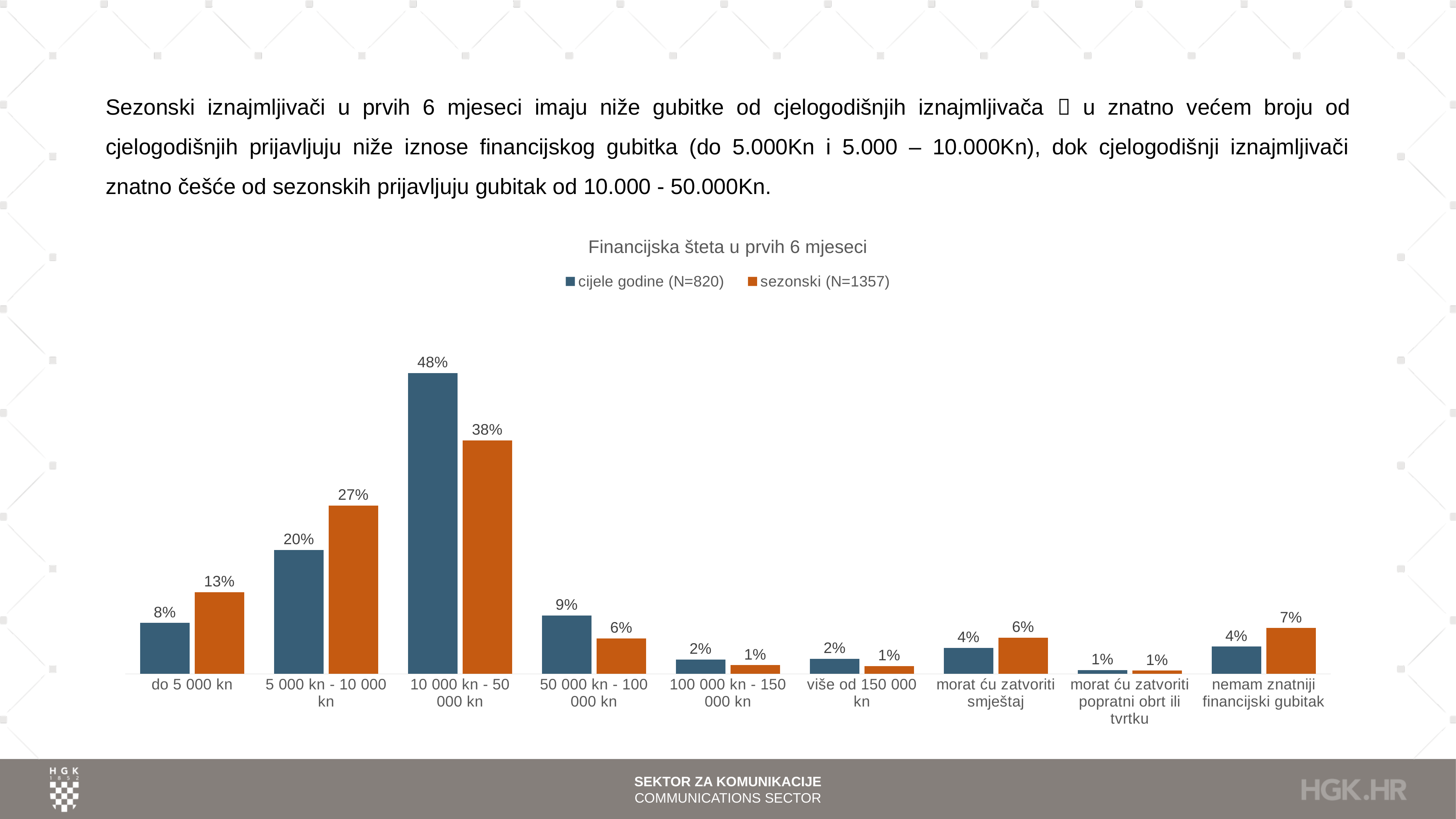
What is the title of the chart? Financijska šteta u prvih 6 mjeseci What is the difference between the 'cijele godine (N=820)' and 'sezonski (N=1357)' values in the '10 000 kn - 50 000 kn' category? 10% In the '50 000 kn - 100 000 kn' category, which series has the larger value? cijele godine (N=820) Which category has the highest value for the 'cijele godine (N=820)' series? 10 000 kn - 50 000 kn What kind of chart is shown on the slide? bar chart What is the value for 'sezonski (N=1357)' in the 'nemam znatniji financijski gubitak' category? 7% How many series does the legend list? 2 In the 'do 5 000 kn' category, which series has the larger value? sezonski (N=1357) What is the value for 'sezonski (N=1357)' in the '5 000 kn - 10 000 kn' category? 27% How many categories are shown on the x axis of the chart? 9 What is the value for 'cijele godine (N=820)' in the '10 000 kn - 50 000 kn' category? 48%